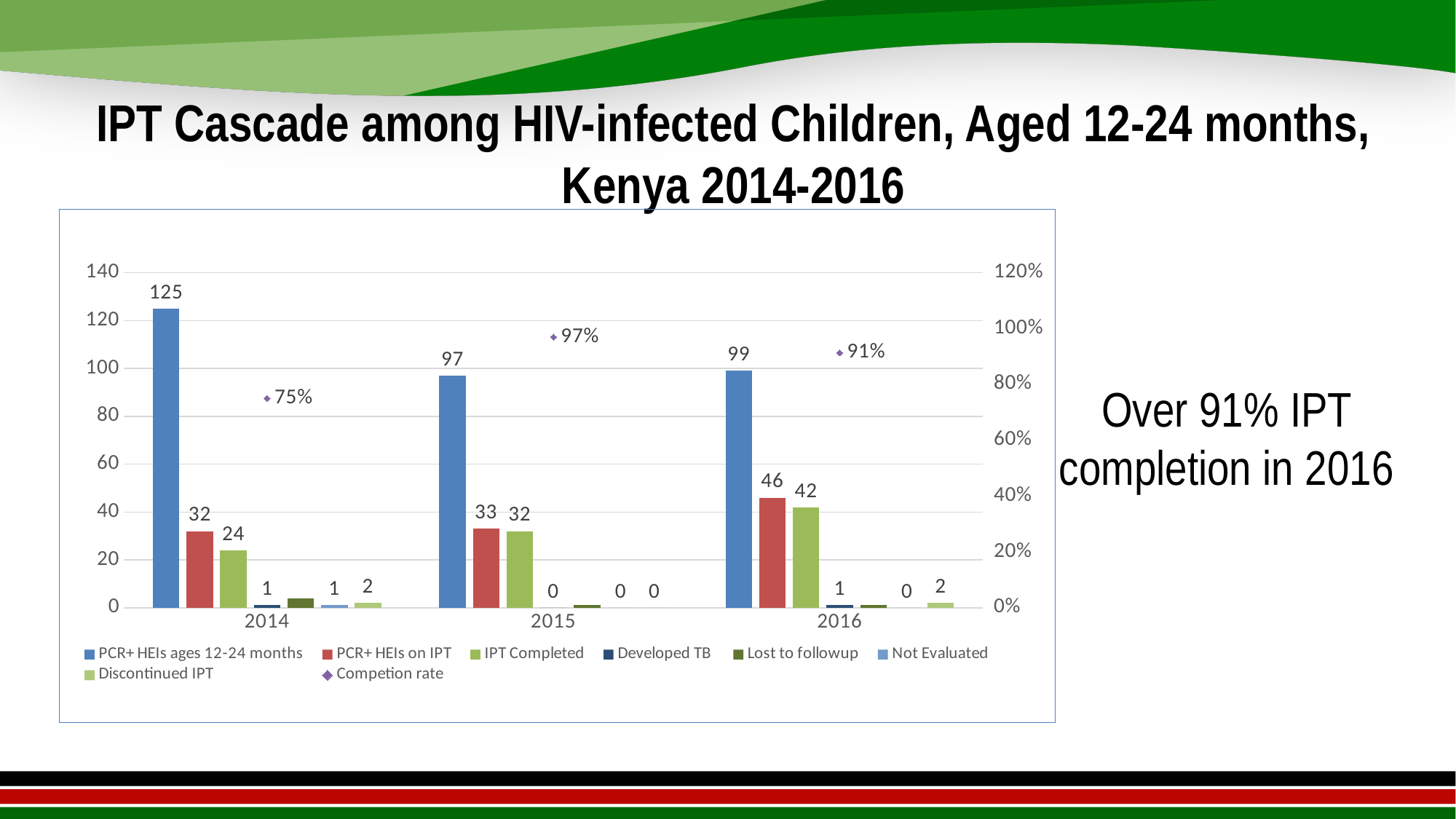
How many years are shown on the x axis? 3 What is the value for PCR+ HEIs ages 12-24 months in 2014? 125 What is the IPT Completed value for 2015? 32 Which year has the highest Competion rate? 2015 What kind of chart is this? Bar chart with completion rate markers How many series does the legend list? 8 Which year has the lowest value for PCR+ HEIs ages 12-24 months? 2015 What is the difference between PCR+ HEIs on IPT and IPT Completed in 2014? 8 What is the value for PCR+ HEIs on IPT in 2016? 46 Does the IPT Completed value rise or fall from 2014 to 2016? Rise What is the Competion rate shown for 2014? 75% Is the value for PCR+ HEIs on IPT larger in 2015 or in 2016? 2016